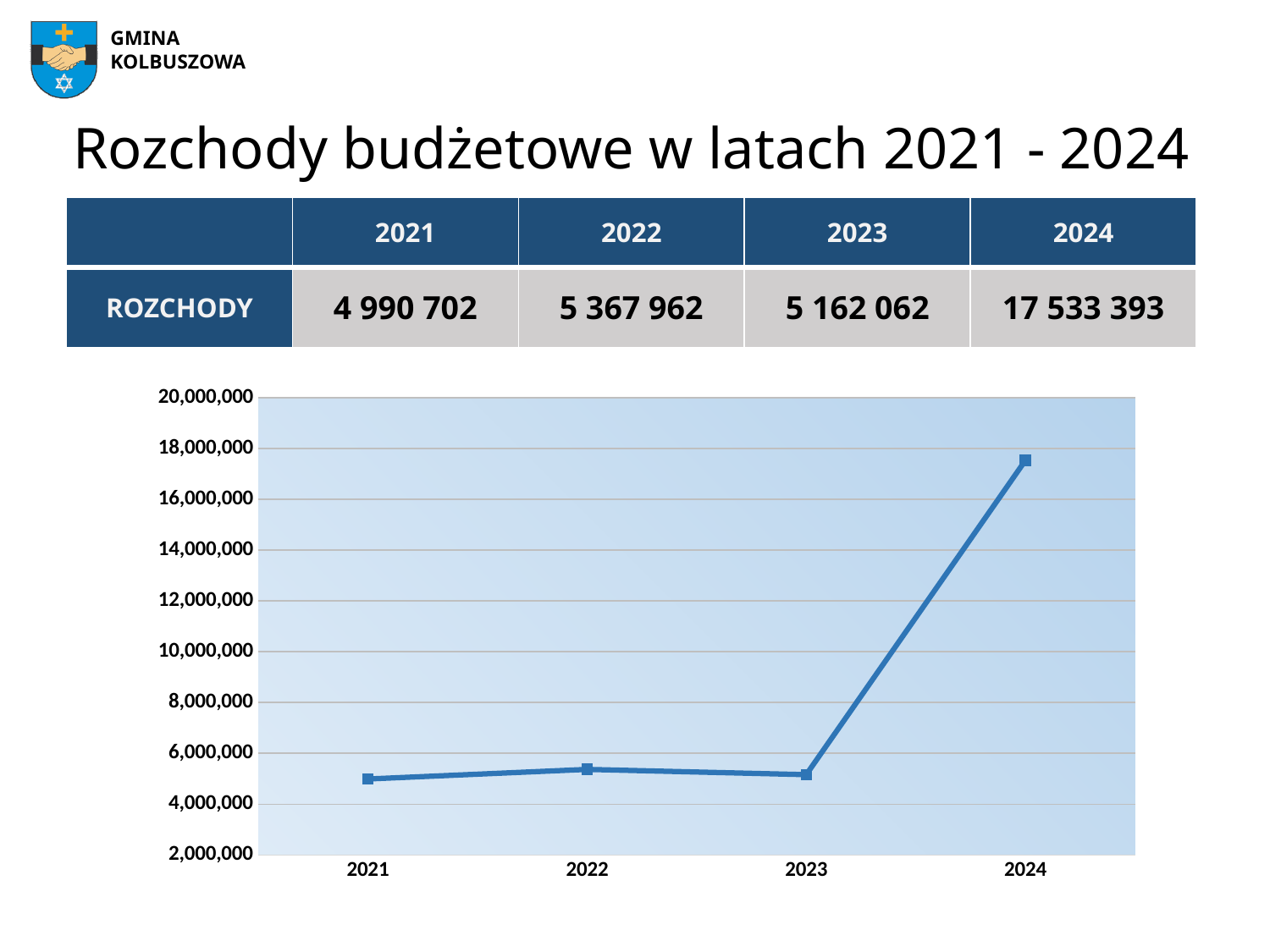
Is the value for 2024 greater or less than 16,000,000? greater What kind of chart is shown on the slide? line chart Which year has the highest rozchody? 2024 What is the difference between rozchody in 2024 and 2023? 12 371 331 Which year has larger rozchody, 2022 or 2023? 2022 What is the value of rozchody for 2024? 17 533 393 How many years are plotted on the chart? 4 What is the value of rozchody for 2023? 5 162 062 What is the value of rozchody for 2021? 4 990 702 Which year has the lowest rozchody? 2021 Do the values rise or fall from 2023 to 2024? rise What is the value of rozchody for 2022? 5 367 962